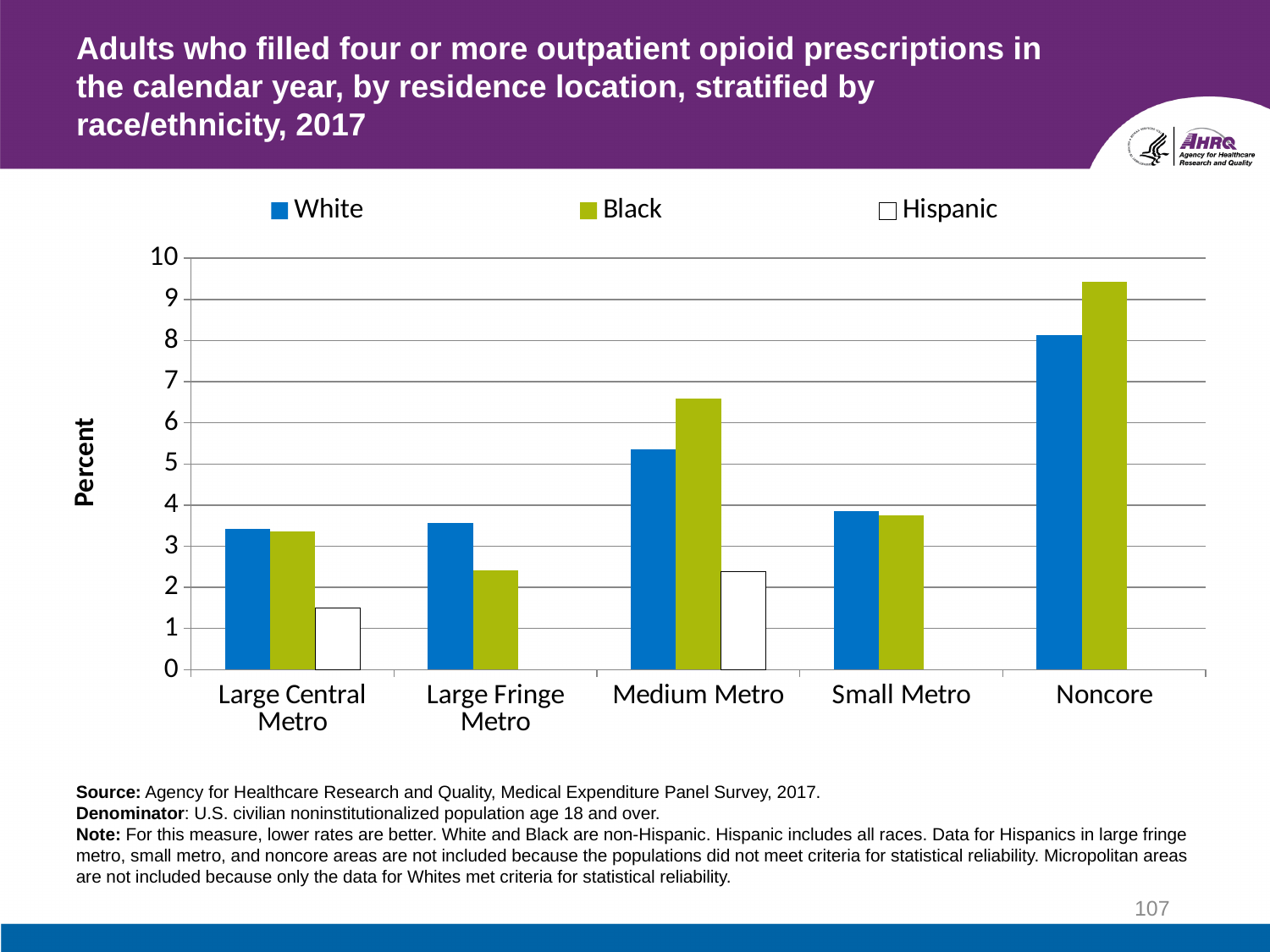
In Medium Metro areas, which is larger: the value for White adults or for Black adults? Black How many series does the legend list? 3 Is the value for Black adults in Noncore areas greater or less than 9? greater In Large Fringe Metro areas, which is larger: the value for White adults or for Black adults? White Is the value for White adults in Noncore areas greater or less than 7? greater How many residence location categories are shown on the x axis? 5 Which residence location has the highest value for Black adults? Noncore Is the value for Hispanic adults in Large Central Metro areas greater or less than 2? less What kind of chart is shown on the slide? Bar chart What is the label on the y axis of the chart? Percent Which residence location has the highest value for White adults? Noncore